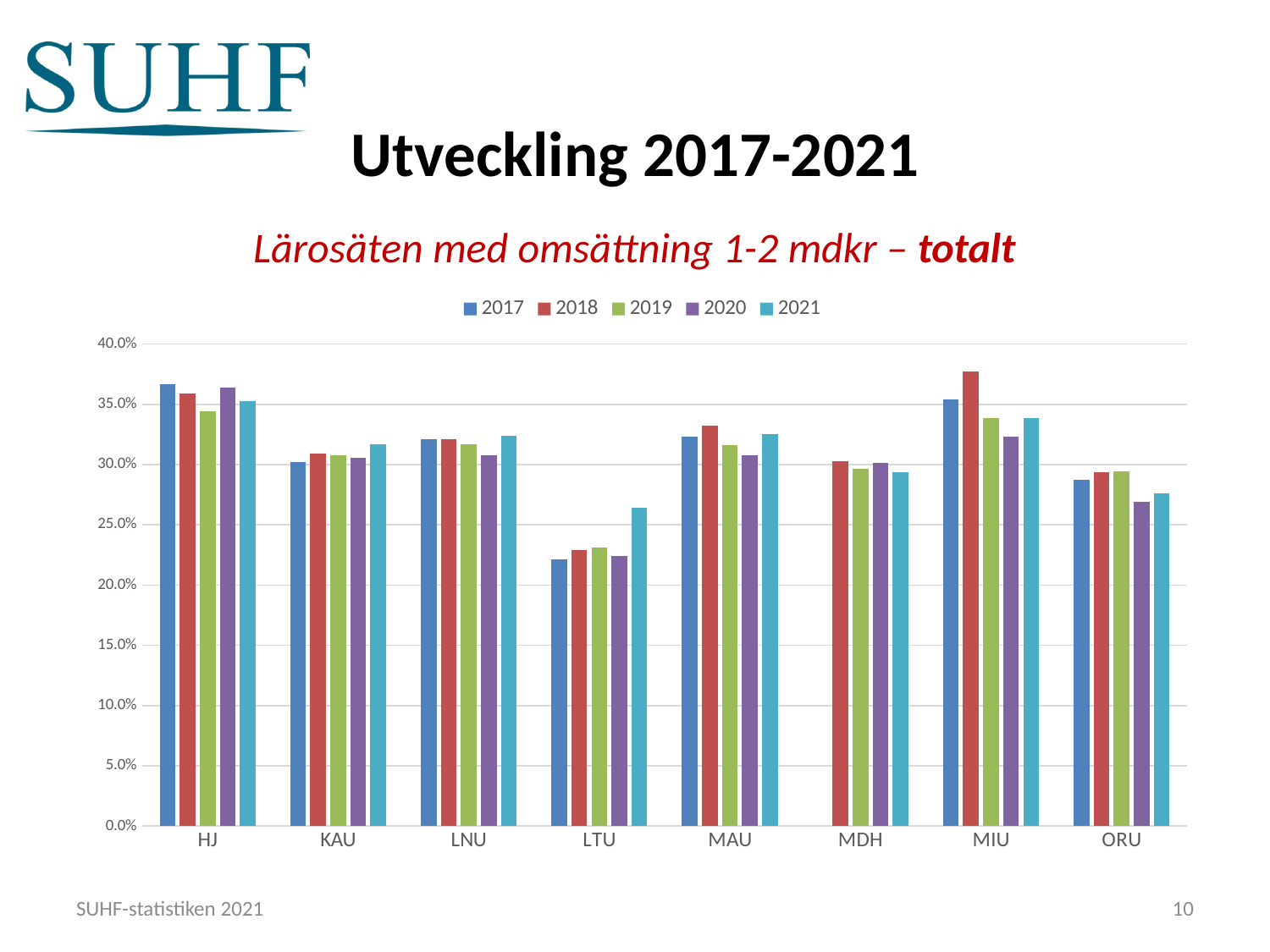
For LTU, which is larger: the value for 2017 or the value for 2021? 2021 Is the value for HJ in 2017 greater or less than 35.0%? greater What kind of chart is shown on the slide? bar chart Is the value for LTU in 2017 greater or less than 25.0%? less How many series does the legend list? 5 Which institution has no bar for 2017? MDH How many institutions (categories) are shown on the x axis? 8 Is the value for MDH in 2021 greater or less than 30.0%? less Which institution has the lowest value for 2021? LTU Which institution has the lowest value for 2017? LTU Which institution has the highest value for 2018? MIU